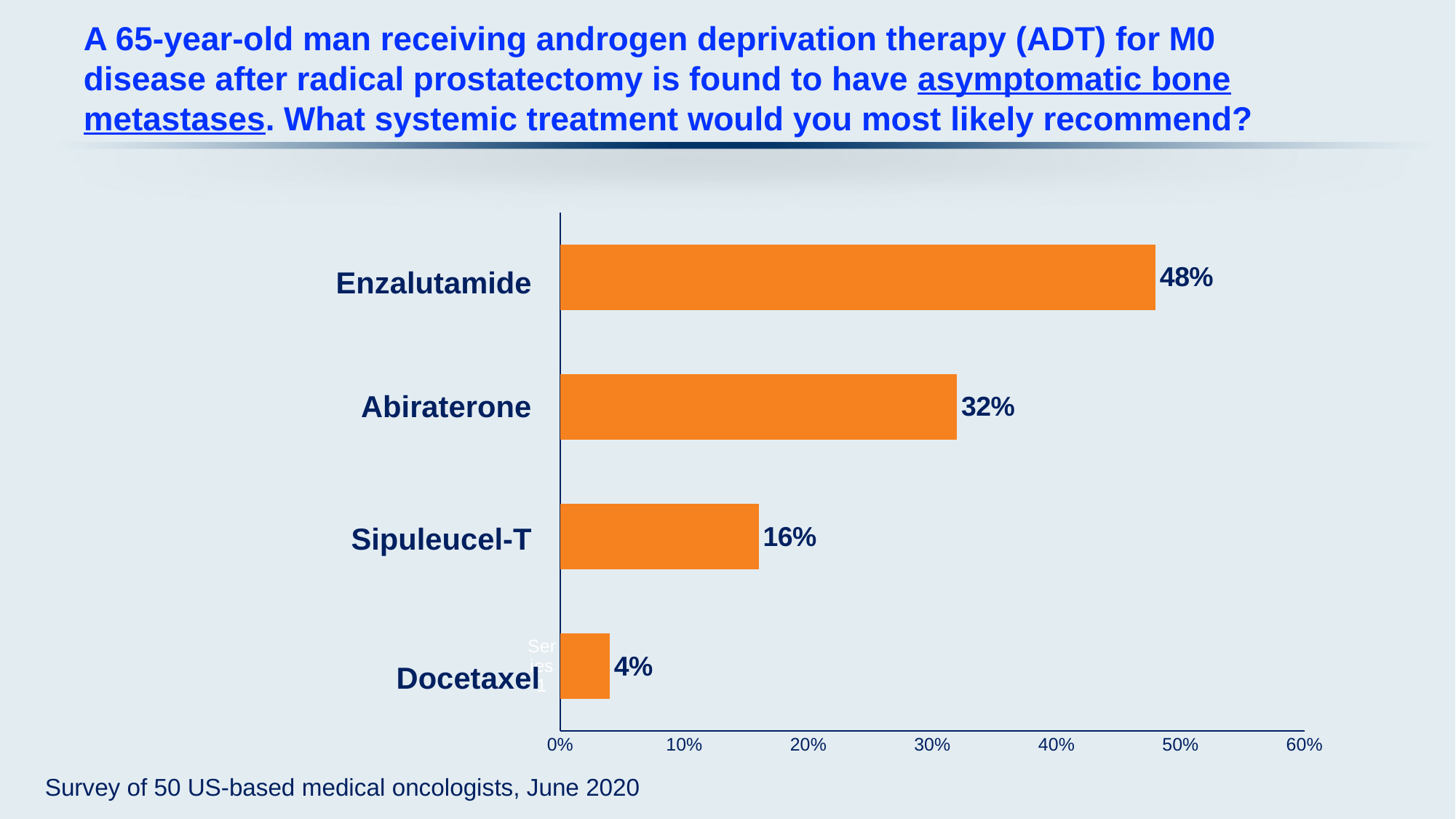
What is the difference in percentage points between Enzalutamide and Abiraterone? 16 What percentage of respondents would recommend Docetaxel? 4% Which has a larger share of respondents, Abiraterone or Sipuleucel-T? Abiraterone Is the value for Enzalutamide greater or less than 40%? greater What percentage of respondents would recommend Enzalutamide? 48% What percentage of respondents would recommend Abiraterone? 32% What is the difference in percentage points between Sipuleucel-T and Docetaxel? 12 Which treatment has the highest percentage of respondents? Enzalutamide How many treatment options are shown in the chart? 4 Which treatment has the lowest percentage of respondents? Docetaxel What percentage of respondents would recommend Sipuleucel-T? 16% What kind of chart is shown on the slide? Bar chart